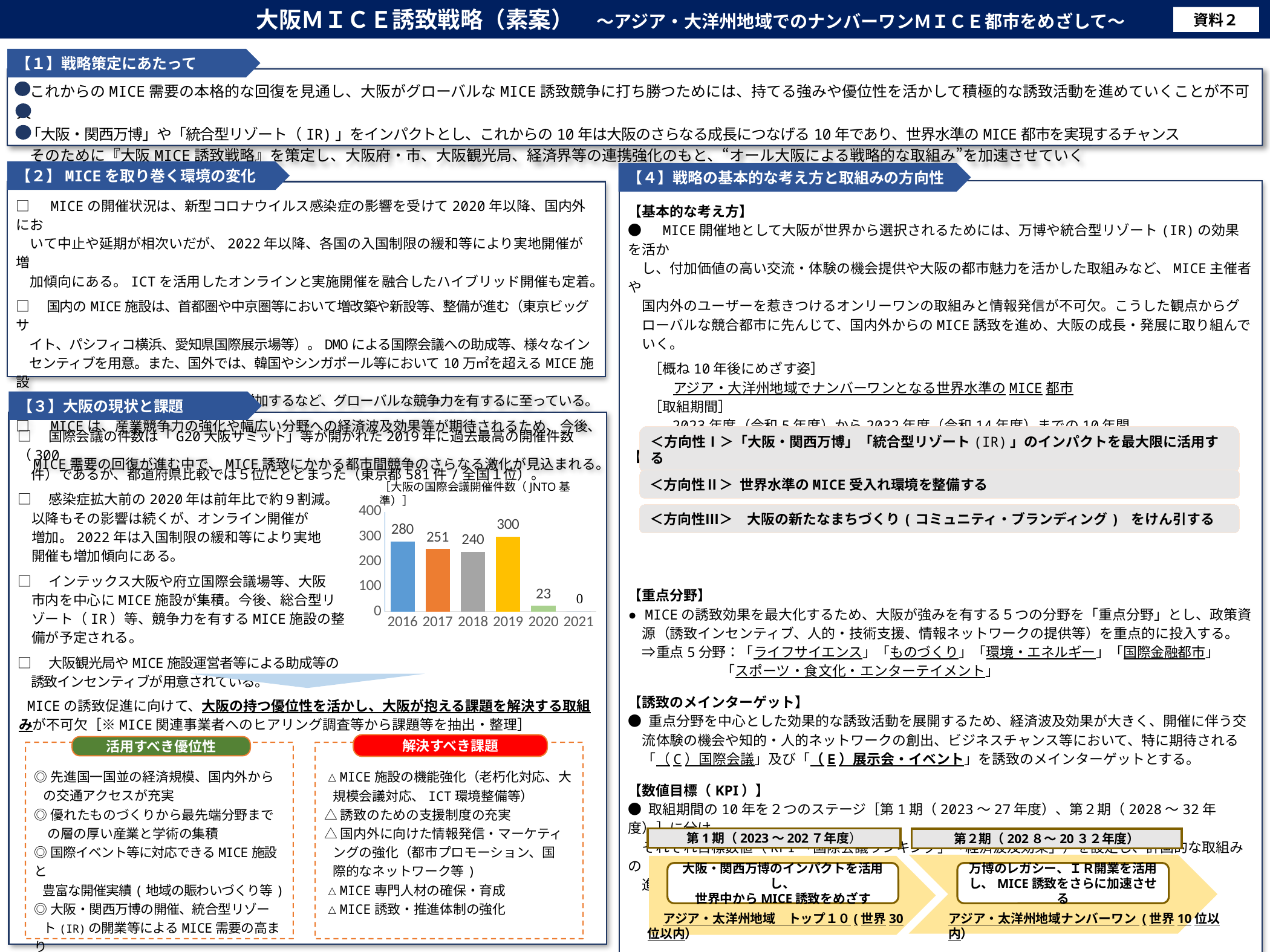
What is the value for 2021 in the bar chart? 0 How many years are shown on the x axis of the bar chart? 6 What is the value for 2016 in the bar chart of Osaka's international conference counts? 280 What kind of chart is used to show Osaka's international conference counts? bar chart Which year has the lowest value in the bar chart? 2021 Which is larger in the bar chart, the value for 2017 or the value for 2018? 2017 Which year has the highest value in the bar chart? 2019 What is the value for 2019 in the bar chart? 300 What is the value for 2020 in the bar chart? 23 What is the difference between the values for 2019 and 2018 in the bar chart? 60 What is the title of the chart on the slide? 大阪の国際会議開催件数（JNTO基準） What is the difference between the values for 2016 and 2017 in the bar chart? 29